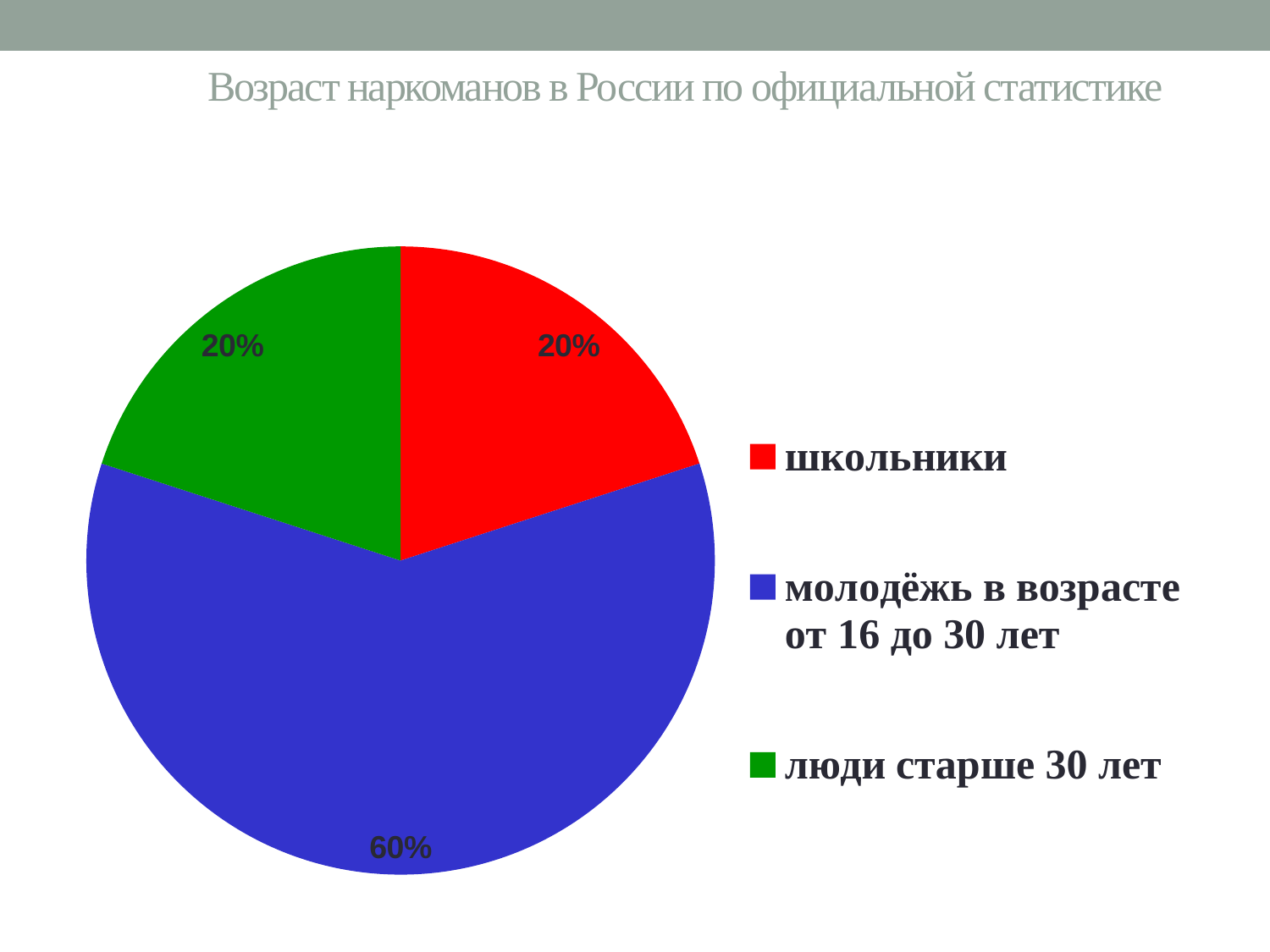
What share of the pie is labelled for молодёжь в возрасте от 16 до 30 лет? 60% How many entries does the legend list? 3 What is the combined share of школьники and люди старше 30 лет? 40% What share of the pie is labelled for люди старше 30 лет? 20% Which category has the largest slice of the pie? молодёжь в возрасте от 16 до 30 лет What kind of chart is shown on the slide? pie chart Which is larger: the slice for молодёжь в возрасте от 16 до 30 лет or the slice for люди старше 30 лет? молодёжь в возрасте от 16 до 30 лет What is the difference between the share for молодёжь в возрасте от 16 до 30 лет and the share for школьники? 40% How many slices does the pie chart have? 3 What colour is the slice for люди старше 30 лет? green What is the title of the slide above the chart? Возраст наркоманов в России по официальной статистике What share of the pie is labelled for школьники? 20%